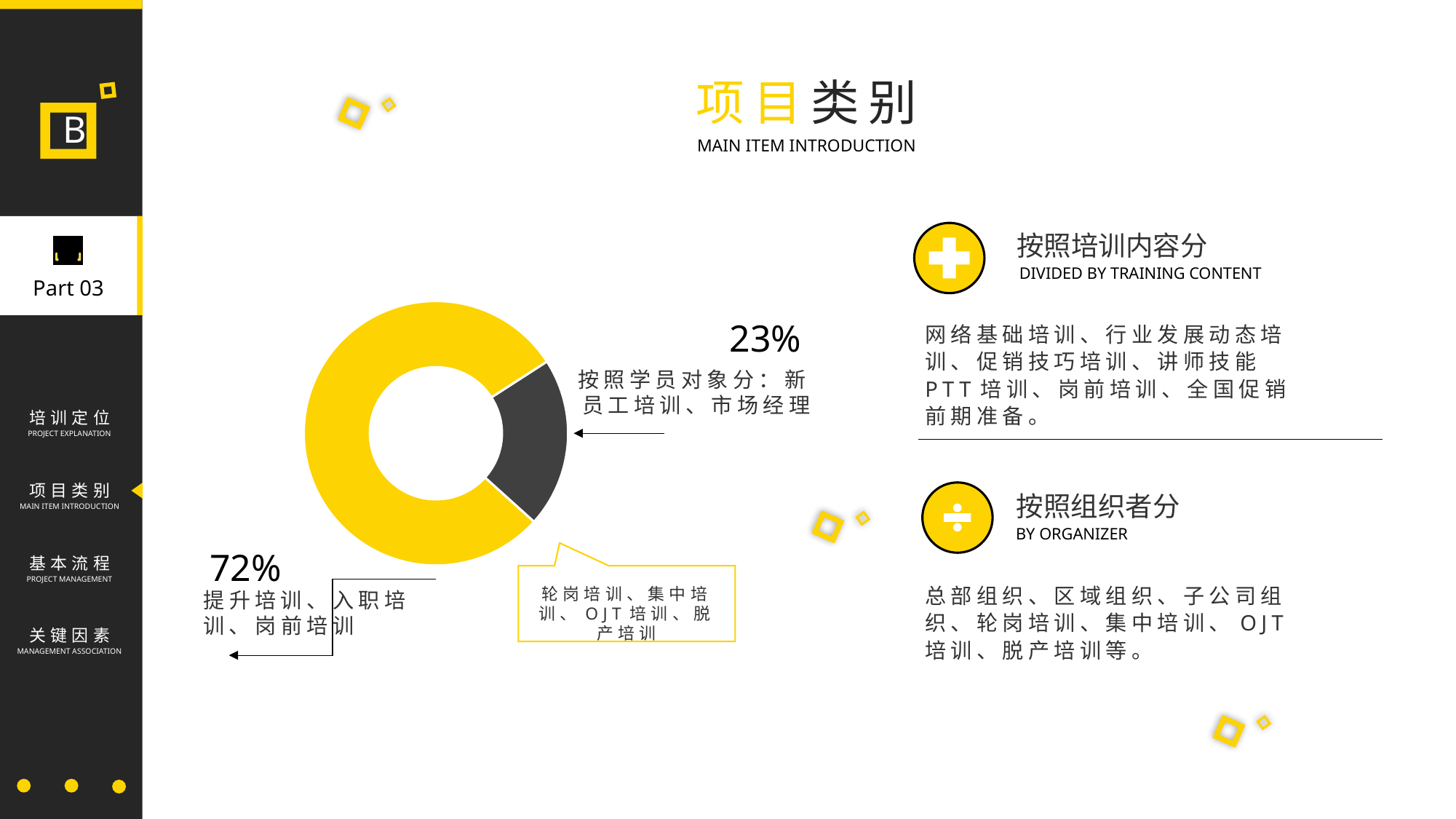
Which is larger: the yellow slice or the dark grey slice? The yellow slice What is the title of the slide containing the donut chart? 项目类别 (MAIN ITEM INTRODUCTION) Which slice of the donut chart is the largest? The yellow slice (72%) Is the yellow slice's share greater or less than 50%? greater What share of the donut is labelled for the slice described as 提升培训、入职培训、岗前培训? 72% Which slice of the donut chart is the smallest? The dark grey slice (23%) What percentage is shown for the dark grey slice of the donut chart? 23% What colour is the slice labelled 23%? Dark grey What is the difference between the 72% slice and the 23% slice? 49 percentage points What kind of chart is shown on the slide? Donut (pie) chart What percentage is shown for the yellow slice of the donut chart? 72% How many slices does the donut chart have? 2